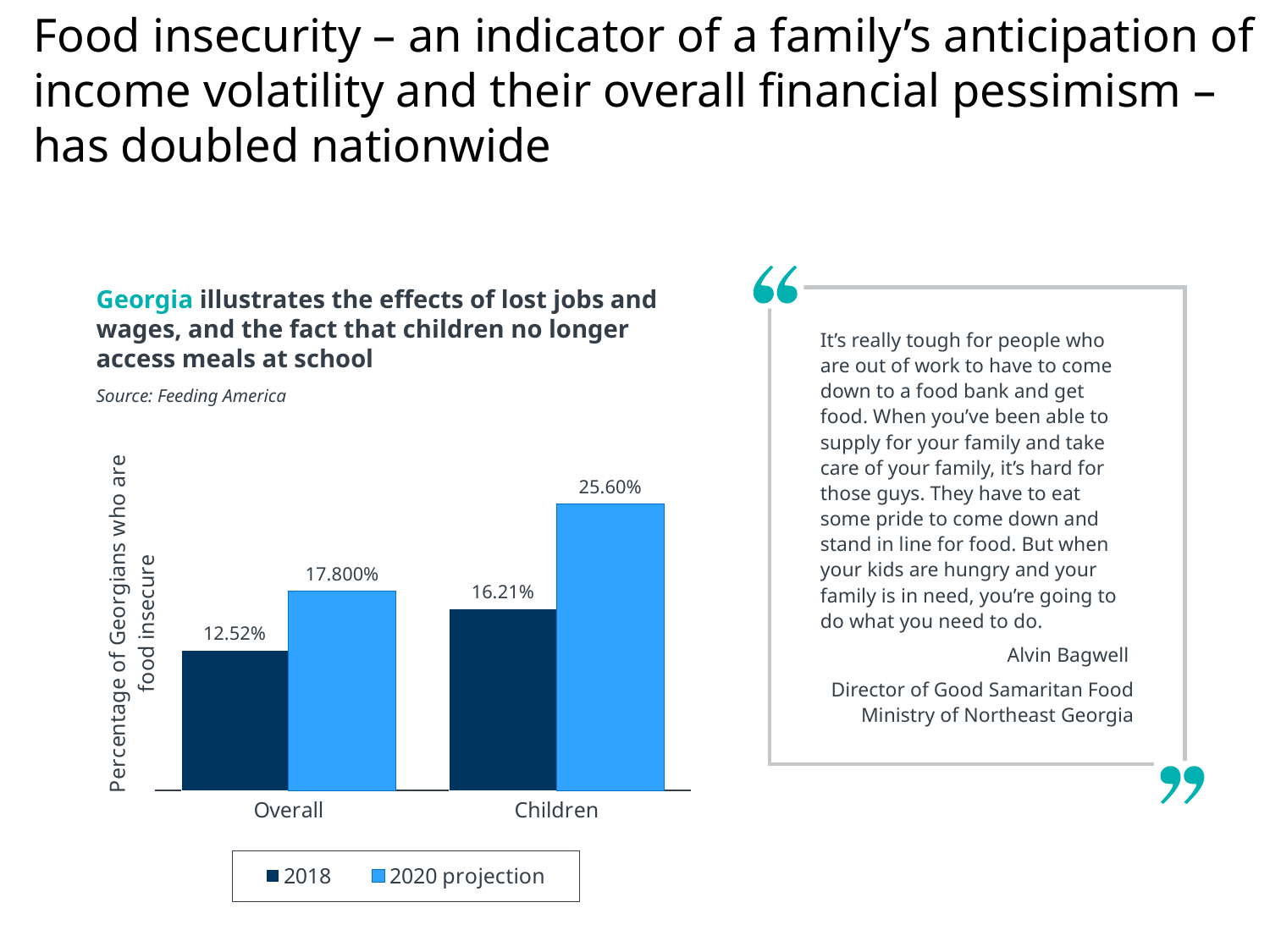
What is the 2018 value for Overall? 12.52% What is the difference between the 2020 projection and 2018 values for Children? 9.39 percentage points What is the difference between the 2020 projection and 2018 values for Overall? 5.28 percentage points Which bar in the chart has the highest value? Children, 2020 projection How many categories are shown on the x axis? 2 Which bar in the chart has the lowest value? Overall, 2018 What kind of chart is shown on the slide? Bar chart Which is larger: the 2018 value for Children or the 2020 projection value for Overall? 2020 projection value for Overall What is the 2020 projection value for Children? 25.60% What is the 2020 projection value for Overall? 17.800% What is the 2018 value for Children? 16.21% How many series does the legend list? 2